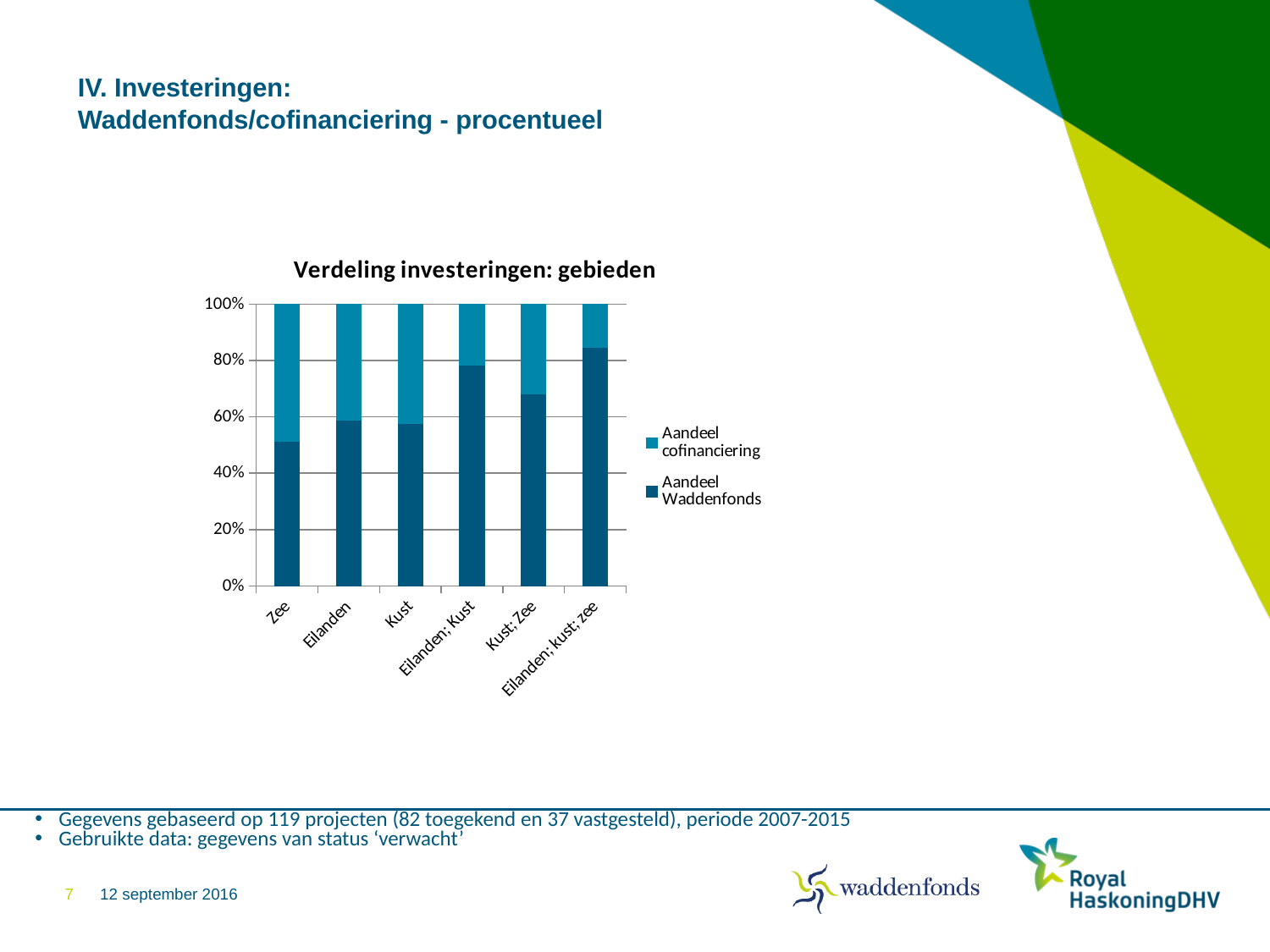
Which has a larger Aandeel Waddenfonds share, Kust; Zee or Kust? Kust; Zee Which category has the lowest share for Aandeel Waddenfonds? Zee Which series is shown in the darker blue colour? Aandeel Waddenfonds Which category has the highest share for Aandeel Waddenfonds? Eilanden; kust; zee Is the Aandeel Waddenfonds share for Eilanden; Kust greater or less than 60%? greater Is the Aandeel Waddenfonds share for Eilanden; kust; zee greater or less than 80%? greater Which category has the highest share for Aandeel cofinanciering? Zee Is the Aandeel Waddenfonds share for Zee greater or less than 60%? less How many categories are shown on the x axis? 6 What is the title of the chart? Verdeling investeringen: gebieden How many series does the legend list? 2 What kind of chart is shown on the slide? stacked bar chart